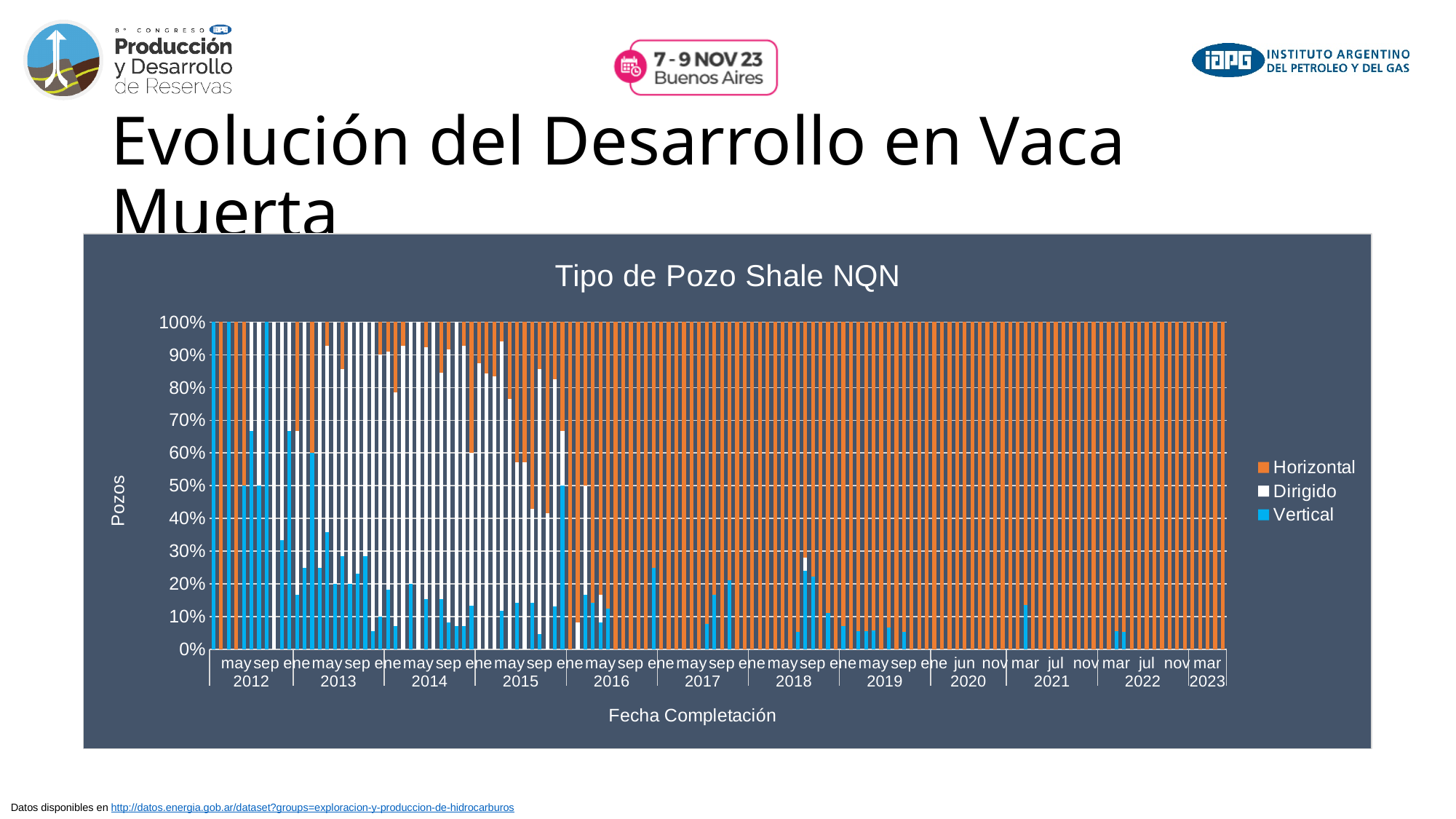
Which series is shown in orange in the chart legend? Horizontal Does the share of Horizontal wells rise or fall from 2012 to 2023? Rise What is the title of the chart? Tipo de Pozo Shale NQN How many series does the chart legend list? 3 Does the share of Vertical wells rise or fall from 2012 to 2023? Fall What is the label of the x axis of the chart? Fecha Completación In 2020, which series has the larger share: Horizontal or Vertical? Horizontal What is the total height of each stacked bar in the chart? 100% What kind of chart is shown on the slide? Stacked bar chart What is the label of the y axis of the chart? Pozos Is the Horizontal share for mar 2023 greater or less than 90%? greater Is the Vertical share for nov 2021 greater or less than 50%? less